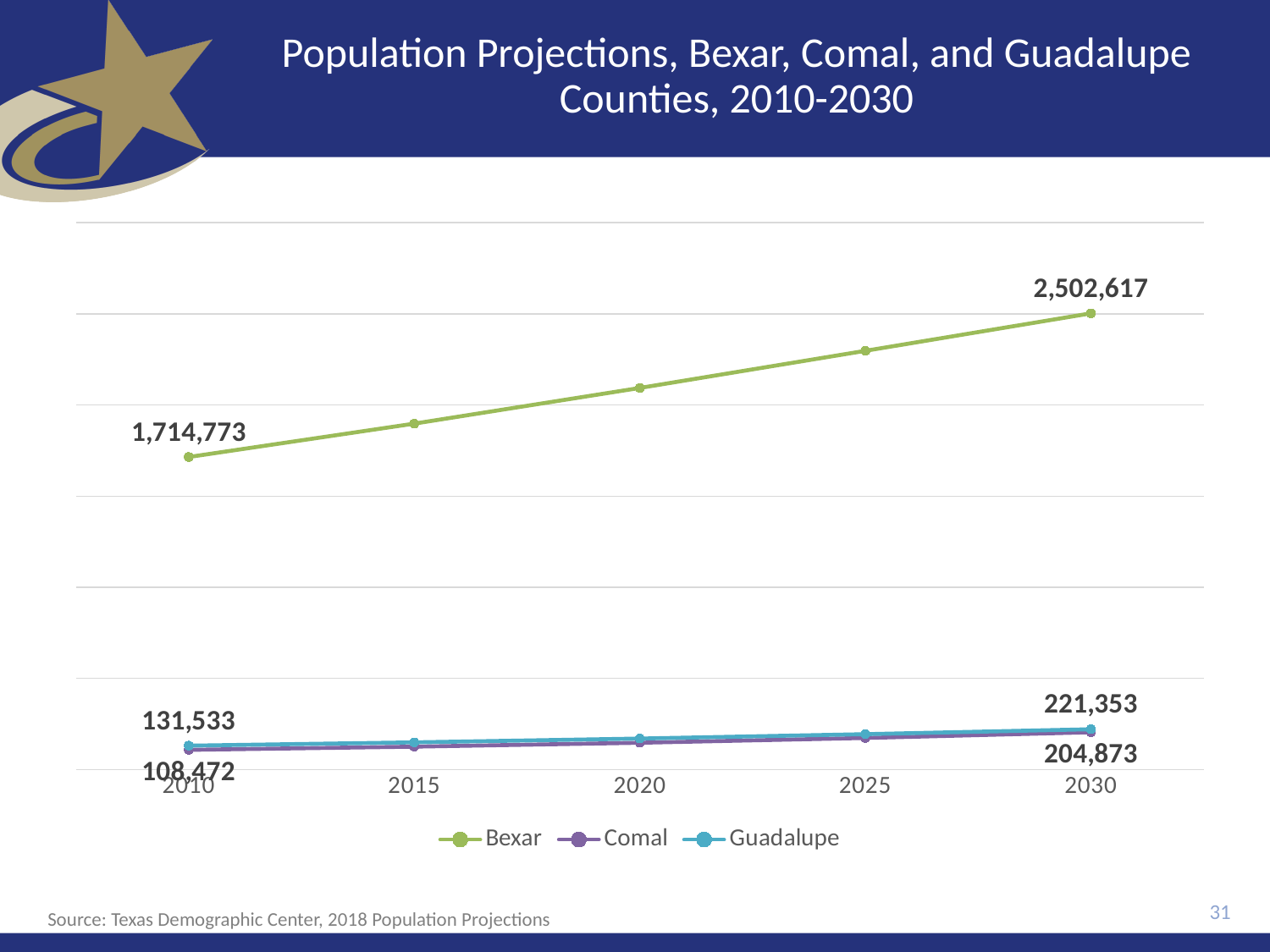
Which county has the lowest projected population in 2010? Comal What is the projected population of Bexar County in 2030? 2,502,617 What is the projected population of Guadalupe County in 2030? 221,353 Which county has the highest projected population in 2030? Bexar Which series is drawn in green? Bexar By how much is Bexar County's population projected to grow from 2010 to 2030? 787,844 Does the Bexar County line rise or fall from 2010 to 2030? Rise How many series does the legend list? 3 What is the projected population of Bexar County in 2010? 1,714,773 How many years are shown on the x axis? 5 What kind of chart is shown on the slide? Line chart What is the projected population of Comal County in 2010? 108,472